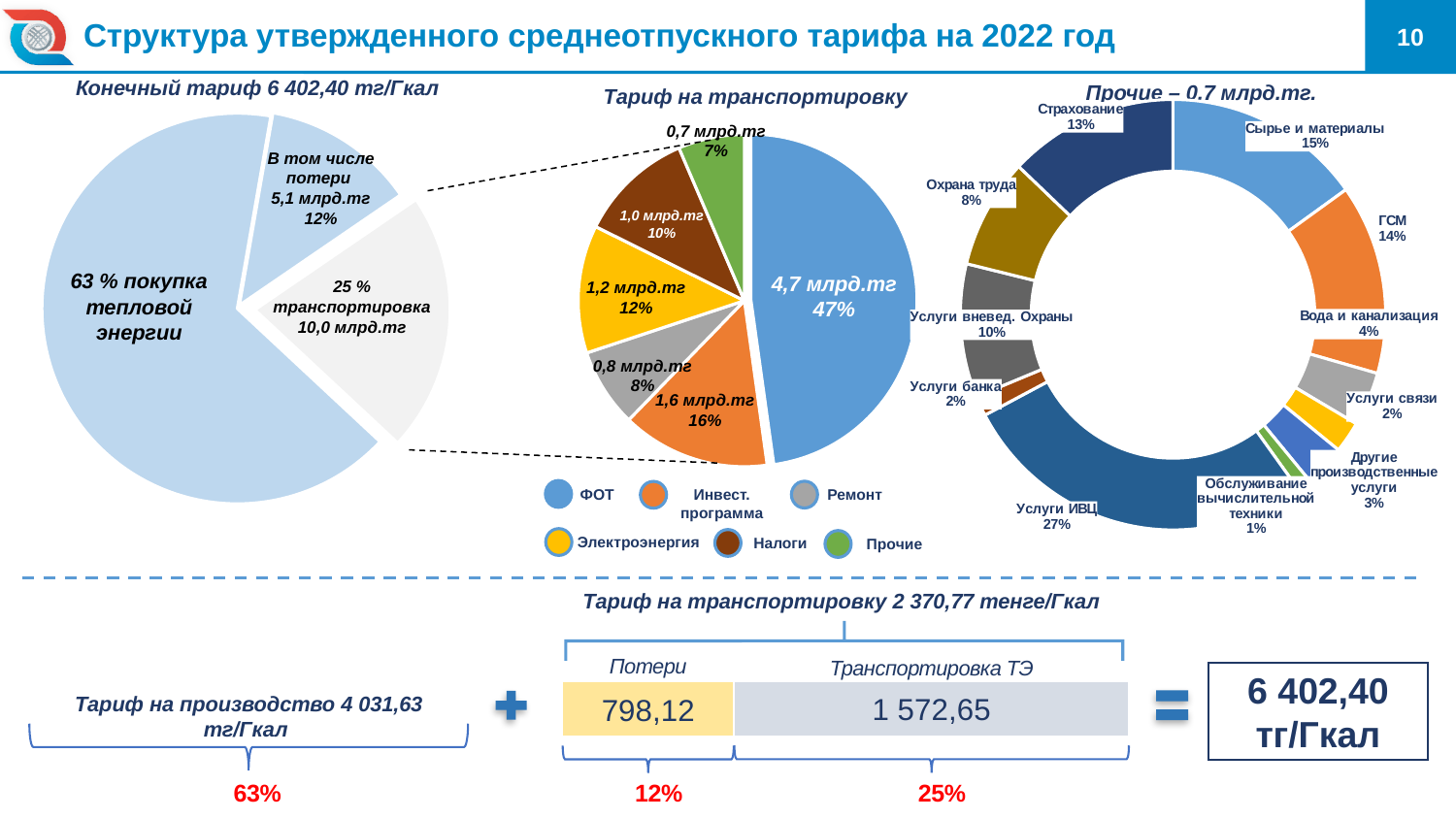
In the right chart 'Прочие – 0.7 млрд.тг', what share does 'Сырье и материалы' have? 15% In the right chart 'Прочие – 0.7 млрд.тг', which category has the largest share? Услуги ИВЦ How many entries does the legend of the middle pie chart 'Тариф на транспортировку' list? 6 What type of chart is 'Прочие – 0.7 млрд.тг' on the right? Donut (pie) chart In the left pie chart 'Конечный тариф 6 402,40 тг/Гкал', what share do 'потери' make up? 12% In the middle pie chart 'Тариф на транспортировку', which is larger: Электроэнергия or Налоги? Электроэнергия In the middle pie chart 'Тариф на транспортировку', which category has the smallest share? Прочие In the left pie chart 'Конечный тариф 6 402,40 тг/Гкал', what share is 'покупка тепловой энергии'? 63 % In the middle pie chart 'Тариф на транспортировку', what is the value for ФОТ? 4,7 млрд.тг In the middle pie chart 'Тариф на транспортировку', what is the difference in млрд.тг between 'Инвест. программа' and 'Ремонт'? 0,8 млрд.тг How many categories are shown in the right chart 'Прочие – 0.7 млрд.тг'? 11 In the left pie chart 'Конечный тариф 6 402,40 тг/Гкал', what is the value of 'транспортировка' in млрд.тг? 10,0 млрд.тг